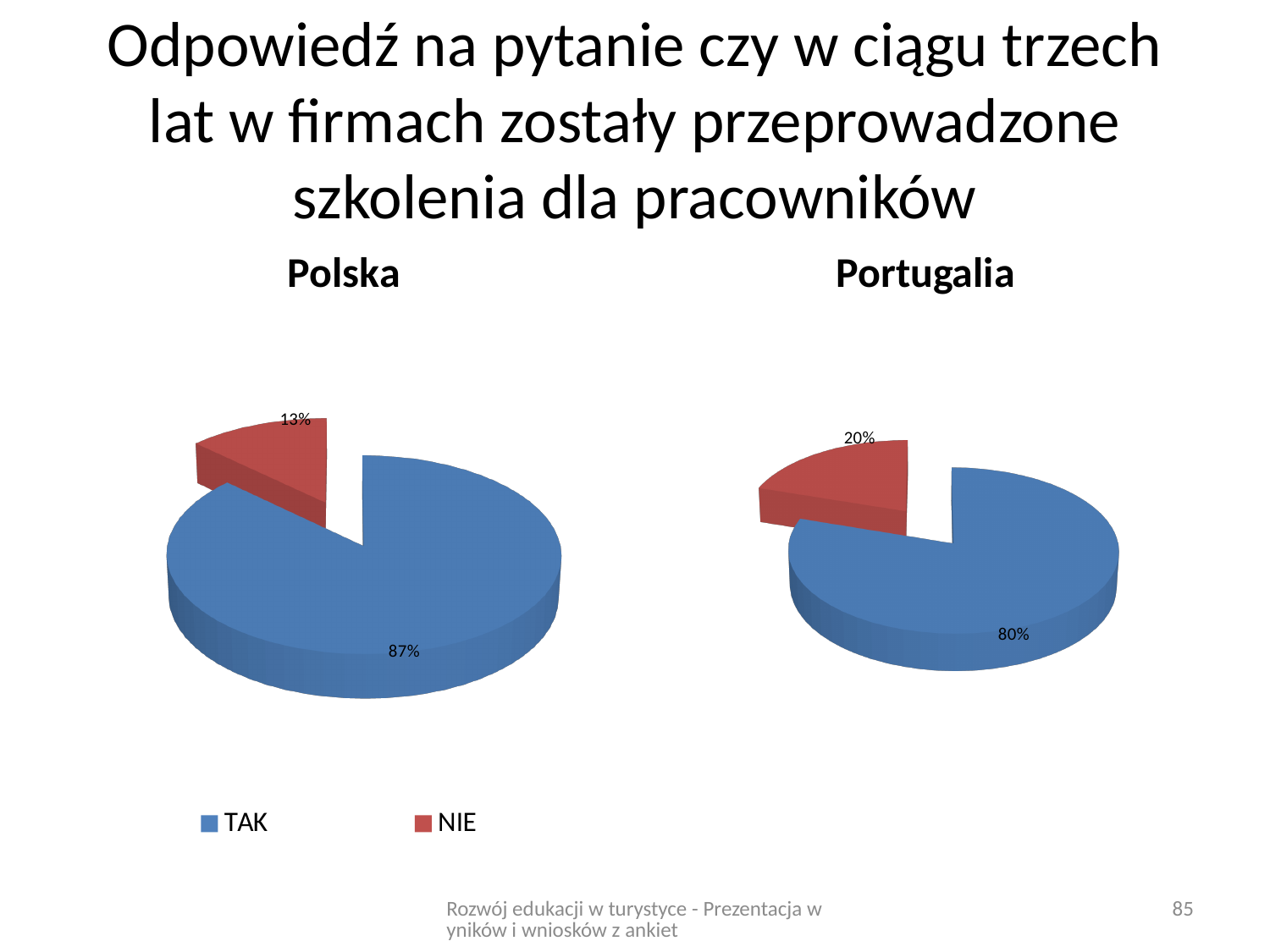
How many slices does the Polska pie chart have? 2 Which colour represents NIE in the legend? Red In the Portugalia pie chart, what share is labelled for TAK? 80% What is the difference between the TAK share in the Polska chart and the TAK share in the Portugalia chart? 7% In the Portugalia pie chart, which slice is the smallest? NIE In the Polska pie chart, what share is labelled for TAK? 87% In the Polska pie chart, which slice is the largest? TAK What type of chart is used for Polska and Portugalia on this slide? Pie chart In the Portugalia pie chart, what share is labelled for NIE? 20% How many entries does the legend list? 2 In the Polska pie chart, what share is labelled for NIE? 13% Which chart shows a larger NIE share, Polska or Portugalia? Portugalia